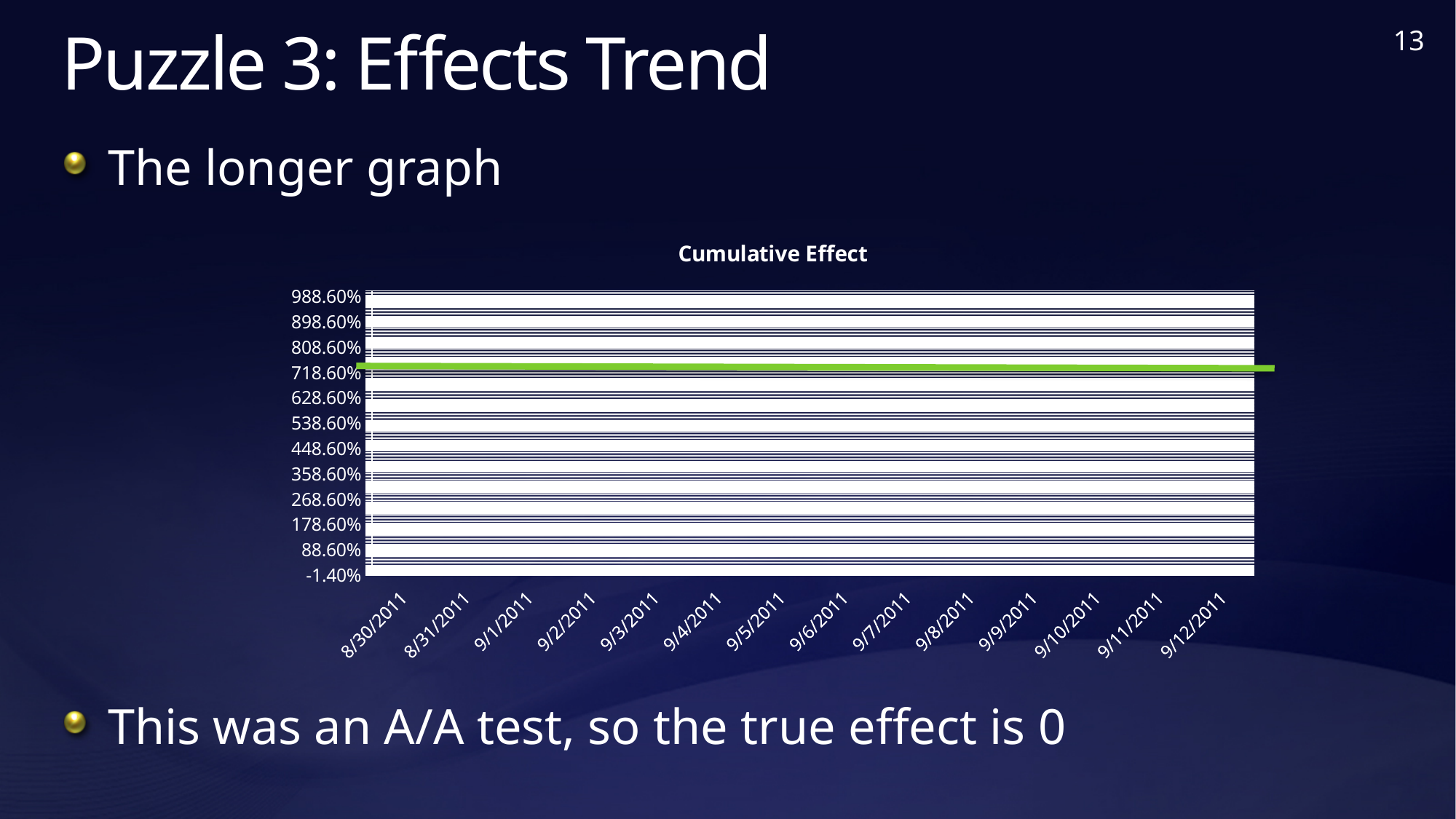
How many tick labels are shown on the y axis? 12 What is the lowest value labelled on the y axis? -1.40% What is the title of the chart? Cumulative Effect Is the value for 8/30/2011 greater or less than 628.60%? greater How many dates are labelled on the x axis of the chart? 14 Does the line rise sharply, fall sharply, or stay roughly flat across the dates? Roughly flat What is the first date shown on the x axis? 8/30/2011 Is the value for 9/5/2011 greater or less than 448.60%? greater What kind of chart is shown on the slide? Line chart What is the highest value labelled on the y axis? 988.60% Is the value for 9/12/2011 greater or less than 808.60%? less What is the last date shown on the x axis of the chart? 9/12/2011